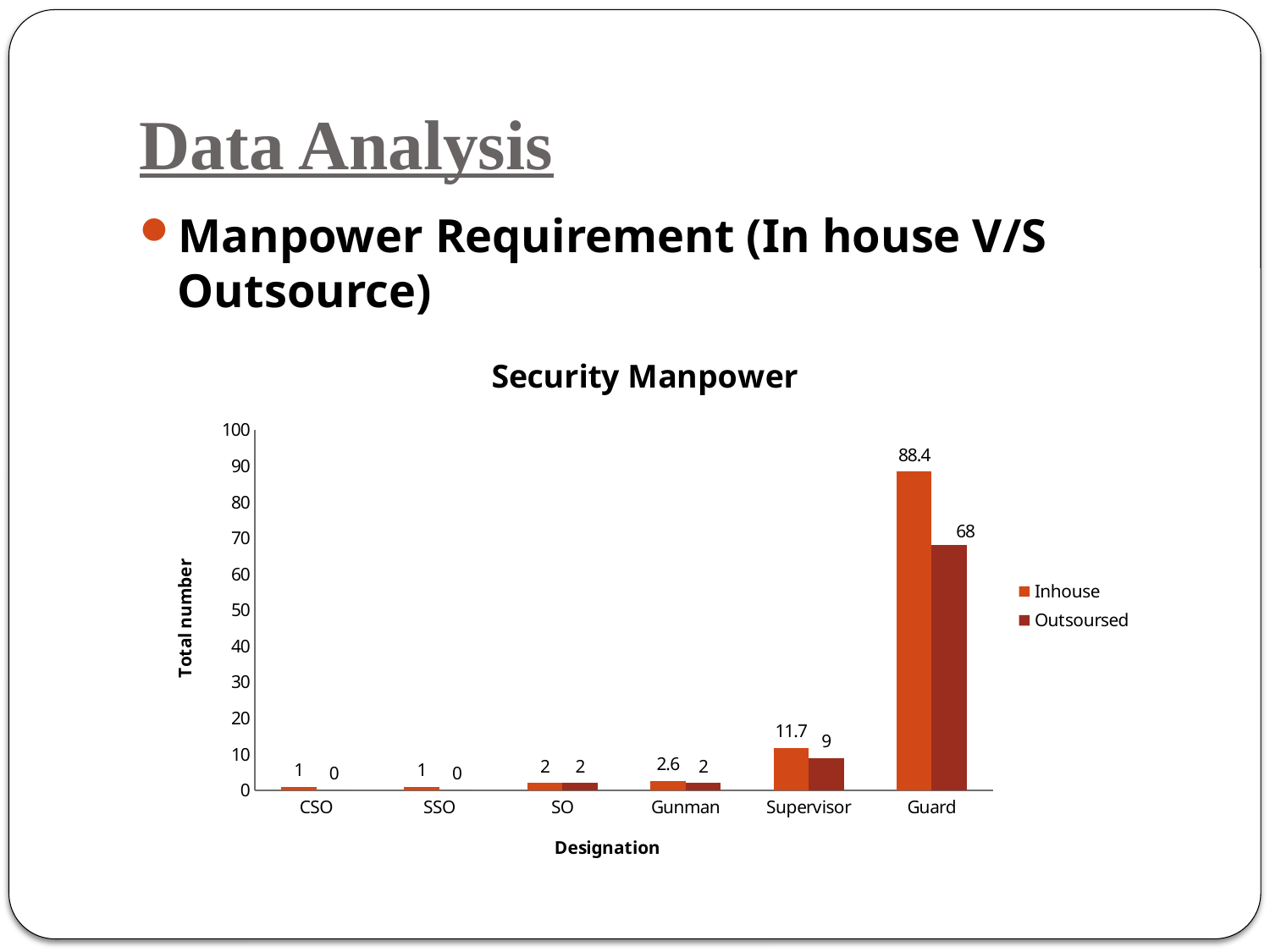
How many series does the legend list? 2 Which designation has the highest Inhouse value? Guard What is the Inhouse value for Gunman? 2.6 What is the Outsoursed value for Supervisor? 9 What is the difference between the Inhouse and Outsoursed values for Supervisor? 2.7 How many designations are shown on the x axis? 6 What is the Inhouse value for Guard? 88.4 What is the title of the chart? Security Manpower What is the Outsoursed value for CSO? 0 What kind of chart is shown? Bar chart What is the difference between the Inhouse and Outsoursed values for Guard? 20.4 Which is larger for Supervisor, the Inhouse value or the Outsoursed value? Inhouse